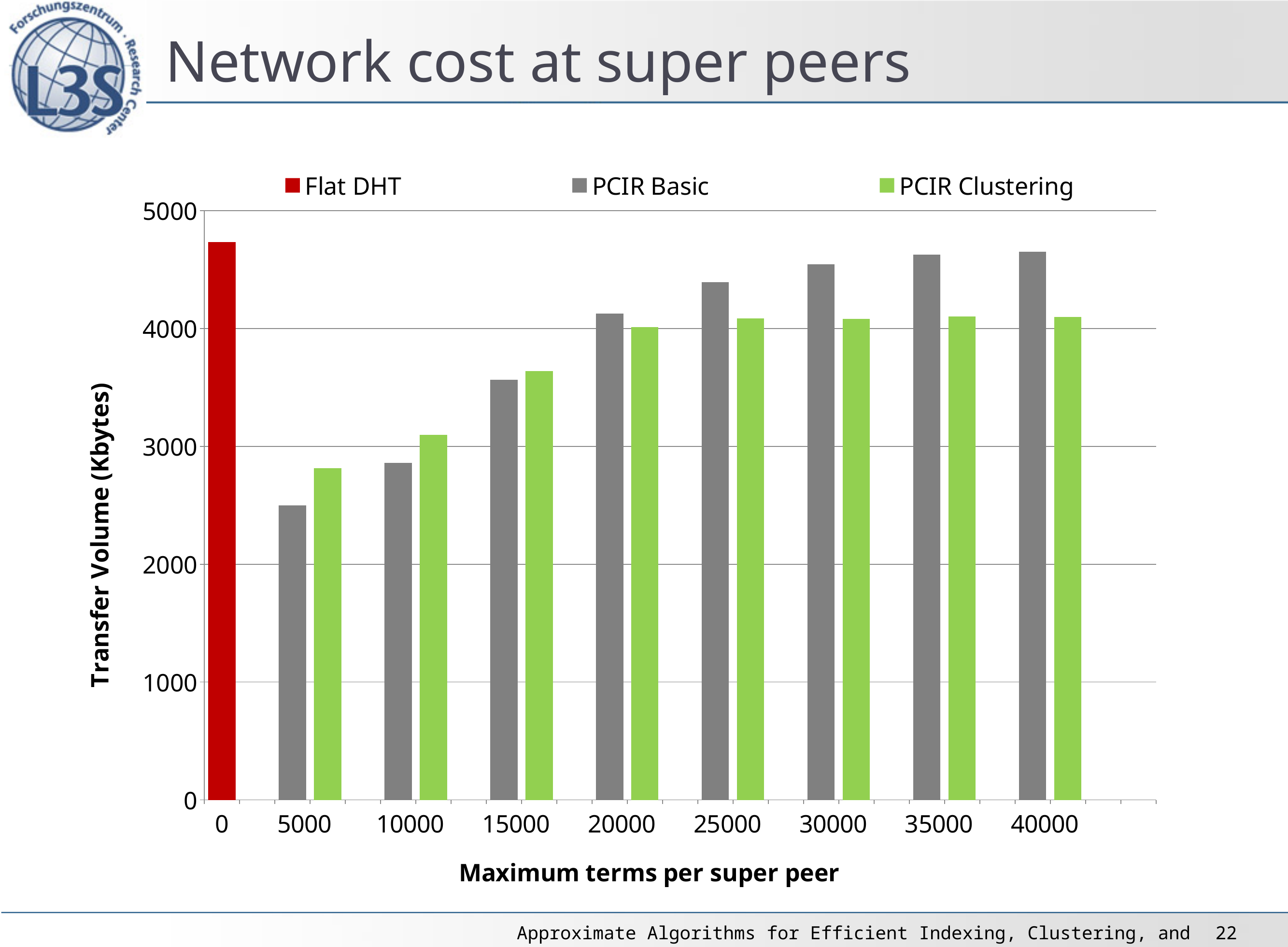
Is the PCIR Basic value at 5000 maximum terms per super peer greater or less than 3000? less Is the Flat DHT value at 0 maximum terms per super peer greater or less than 4000? greater At 40000 maximum terms per super peer, which is larger: PCIR Basic or PCIR Clustering? PCIR Basic Is the PCIR Clustering value at 5000 maximum terms per super peer greater or less than 2000? greater What kind of chart is shown on the slide? bar chart What is the y-axis title of the chart? Transfer Volume (Kbytes) How many x-axis categories (maximum terms per super peer values) are shown? 9 At 5000 maximum terms per super peer, which is larger: PCIR Basic or PCIR Clustering? PCIR Clustering At which maximum terms per super peer value is the PCIR Basic bar lowest? 5000 Do the PCIR Basic values rise or fall as the maximum terms per super peer increases from 5000 to 40000? rise How many series does the legend list? 3